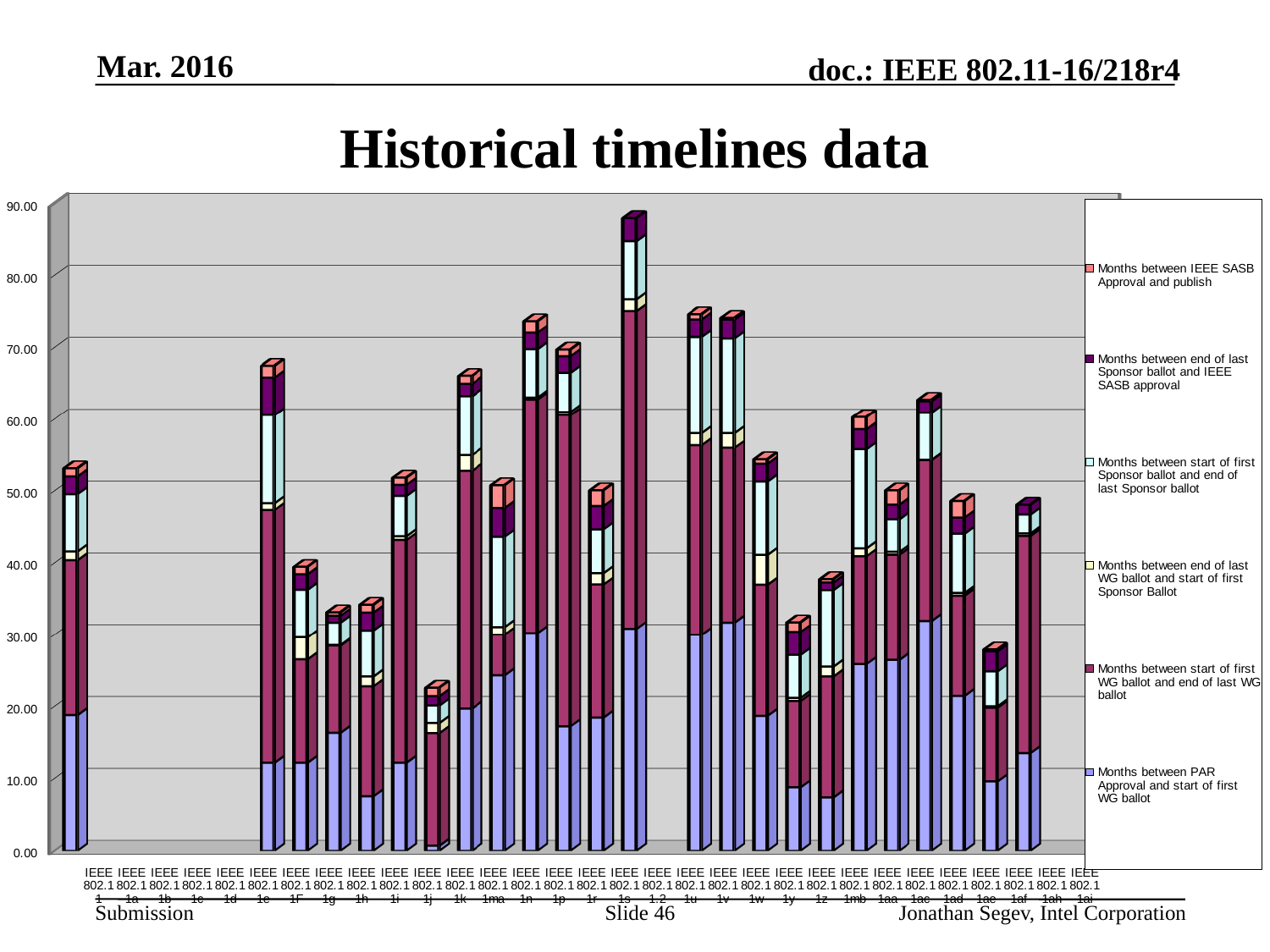
Is the total of the tallest stacked bar greater or less than 80? greater What kind of chart is shown on the slide? stacked bar chart What is the title of the chart? Historical timelines data How many stacked bars are plotted in the chart? 24 Which is taller, the leftmost bar or the second bar from the left? the second bar from the left Is the total of the shortest stacked bar greater or less than 30? less Is the total of the leftmost stacked bar greater or less than 50? greater How many series does the legend list? 6 Which series forms the topmost segment of each stacked bar? Months between IEEE SASB Approval and publish